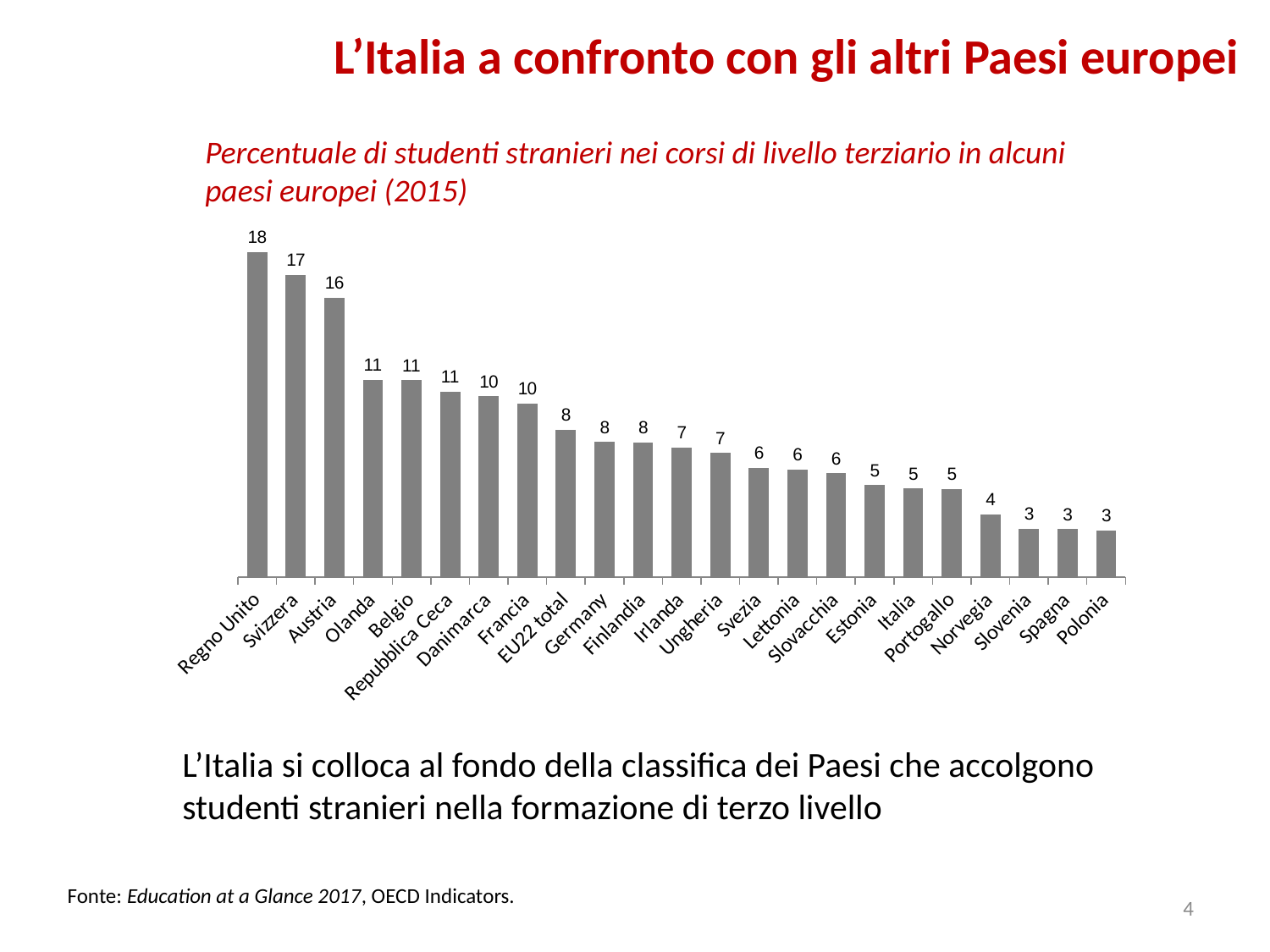
What is the difference between the values for Svizzera and Olanda? 6 What is the value for Norvegia? 4 Do the values rise or fall from left to right along the x axis? Fall What is the value for EU22 total? 8 Which has a larger value, Svizzera or Austria? Svizzera Which country has the highest value? Regno Unito What is the value for Italia? 5 How many categories are shown on the x axis? 23 What is the difference between the values for Regno Unito and Italia? 13 What kind of chart is shown on the slide? Bar chart What is the value for Francia? 10 What is the value for Regno Unito? 18